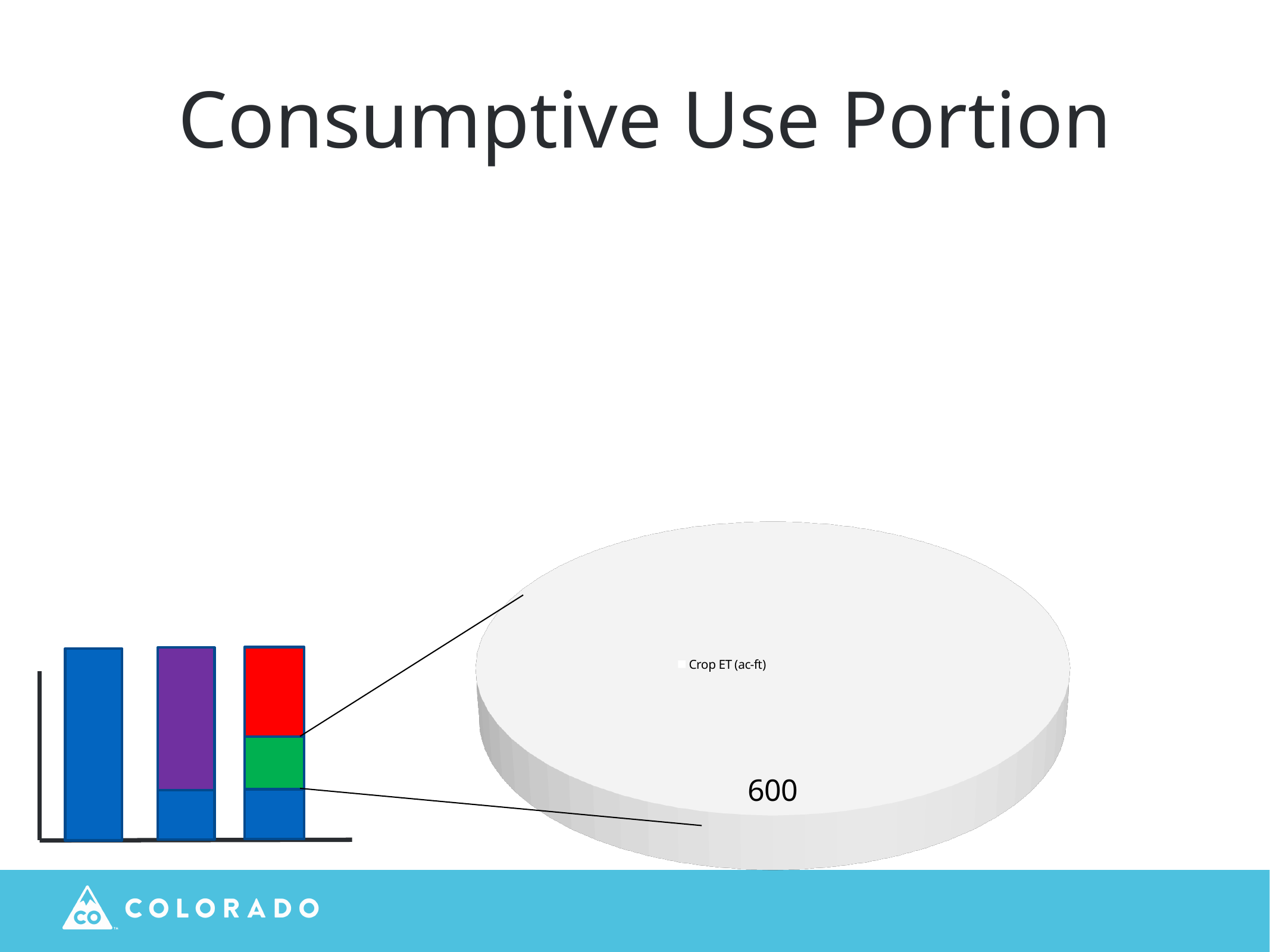
In the pie chart on the right, what value is printed on the slice? 600 How many slices does the pie chart on the right have? 1 What kind of chart is shown on the right side of the slide? pie chart In the bar chart in the bottom-left corner, what colour is the top segment of the rightmost bar? red How many bars does the bar chart in the bottom-left corner have? 3 In the bar chart in the bottom-left corner, how many coloured segments does the rightmost bar have? 3 How many entries does the legend of the pie chart on the right list? 1 In the pie chart on the right, what share of the pie does Crop ET (ac-ft) represent? 100% In the pie chart on the right, what is the value for Crop ET (ac-ft)? 600 What is the legend entry shown in the pie chart on the right? Crop ET (ac-ft) What kind of chart is shown in the bottom-left corner of the slide? bar chart